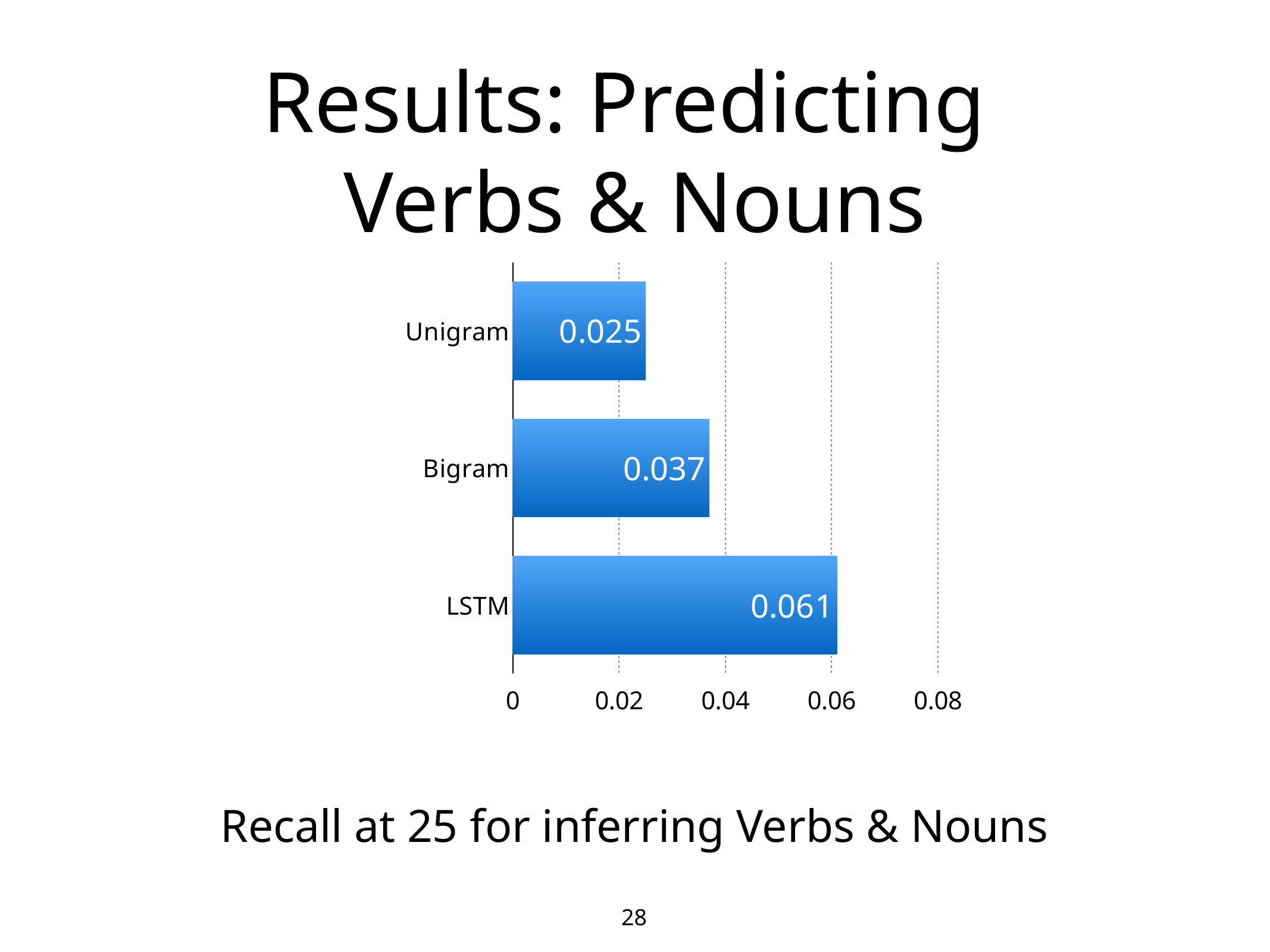
What is the difference between the values for LSTM and Bigram? 0.024 Is the value for LSTM greater or less than 0.04? greater How many categories are shown in the chart? 3 What kind of chart is shown on the slide? bar chart What is the value for Bigram? 0.037 What is the difference between the values for Bigram and Unigram? 0.012 What is the value for LSTM? 0.061 Which category has the lowest value? Unigram What is the value for Unigram? 0.025 Which category has the highest value? LSTM What does the caption below the chart say the values represent? Recall at 25 for inferring Verbs & Nouns Which is larger, the value for Bigram or the value for Unigram? Bigram